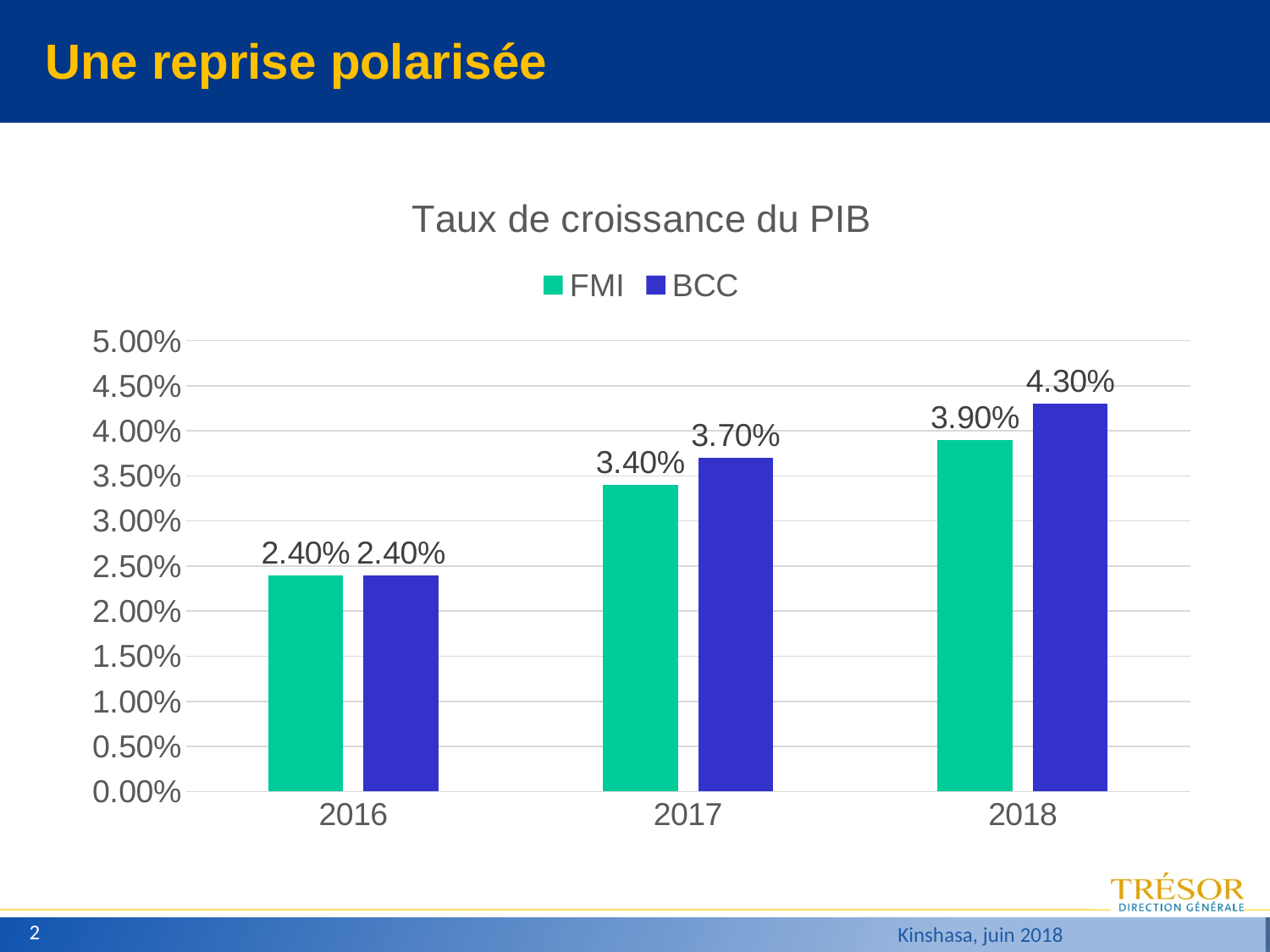
What is the BCC value for 2018? 4.30% What is the difference between the BCC and FMI values for 2018? 0.40% Which year has the lowest FMI value? 2016 What is the FMI value for 2017? 3.40% Do the BCC values rise or fall from 2016 to 2018? Rise Which is larger in 2017, the FMI value or the BCC value? BCC What is the difference between the FMI values for 2017 and 2016? 1.00% Which year has the highest BCC value? 2018 What is the FMI value for 2016? 2.40% How many years are shown on the x axis? 3 What kind of chart is shown? Bar chart How many series does the legend list? 2